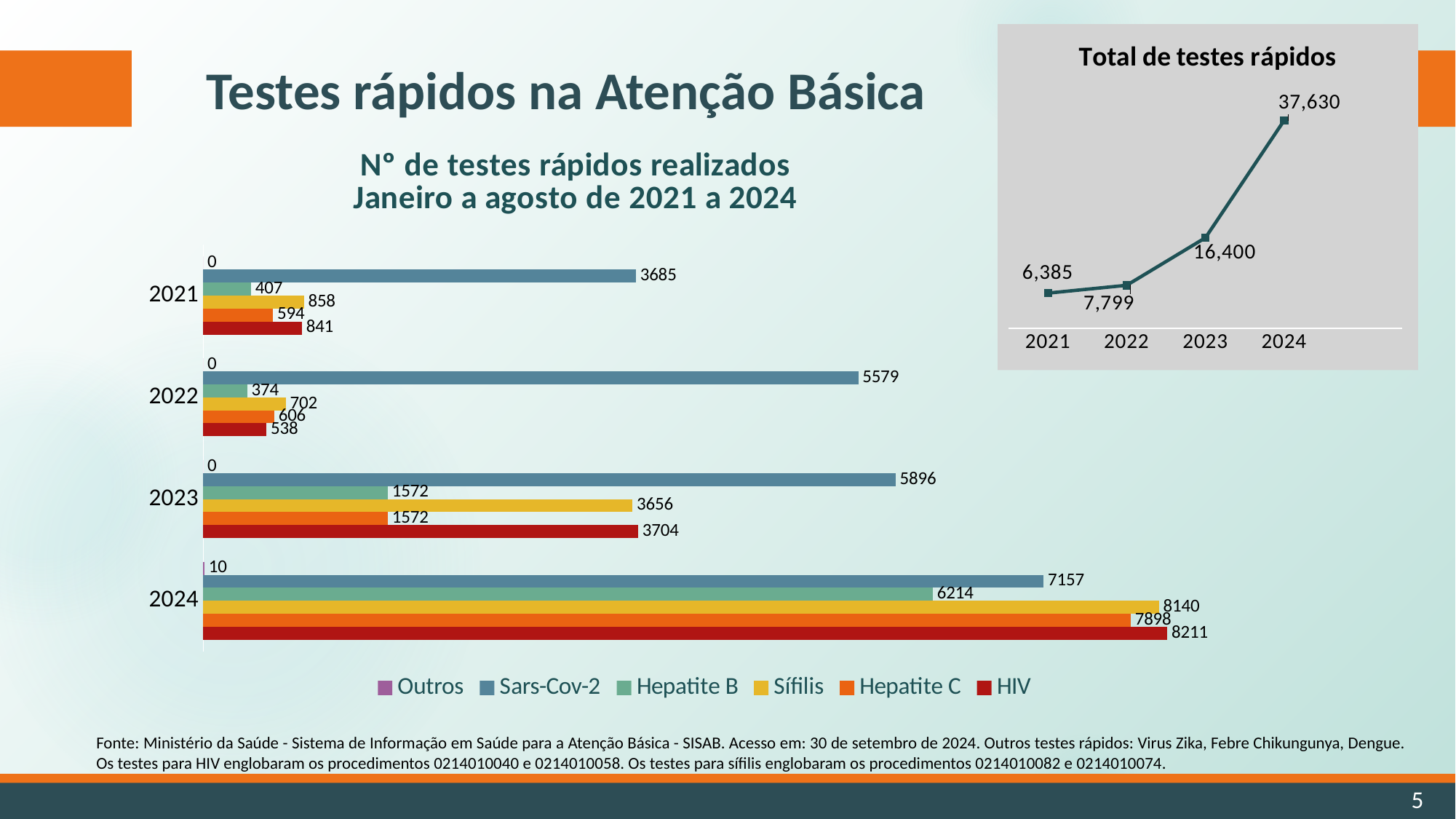
How many series does the legend of the bar chart 'Nº de testes rápidos realizados' list? 6 In the line chart 'Total de testes rápidos', do the values rise or fall from 2021 to 2024? rise In the bar chart 'Nº de testes rápidos realizados', which series has the lowest value in 2022? Outros In the bar chart 'Nº de testes rápidos realizados', what is the value for Hepatite B in 2023? 1572 In the bar chart 'Nº de testes rápidos realizados', what is the value for Sars-Cov-2 in 2021? 3685 In the bar chart 'Nº de testes rápidos realizados', what is the difference between Sífilis and Hepatite C in 2024? 242 What kind of chart is 'Total de testes rápidos'? line chart In the bar chart 'Nº de testes rápidos realizados', which is larger in 2022: Sífilis or HIV? Sífilis In the bar chart 'Nº de testes rápidos realizados', which series has the highest value in 2024? HIV In the bar chart 'Nº de testes rápidos realizados', what is the value for HIV in 2024? 8211 In the line chart 'Total de testes rápidos', what is the value for 2023? 16,400 In the line chart 'Total de testes rápidos', what is the difference between 2024 and 2021? 31,245